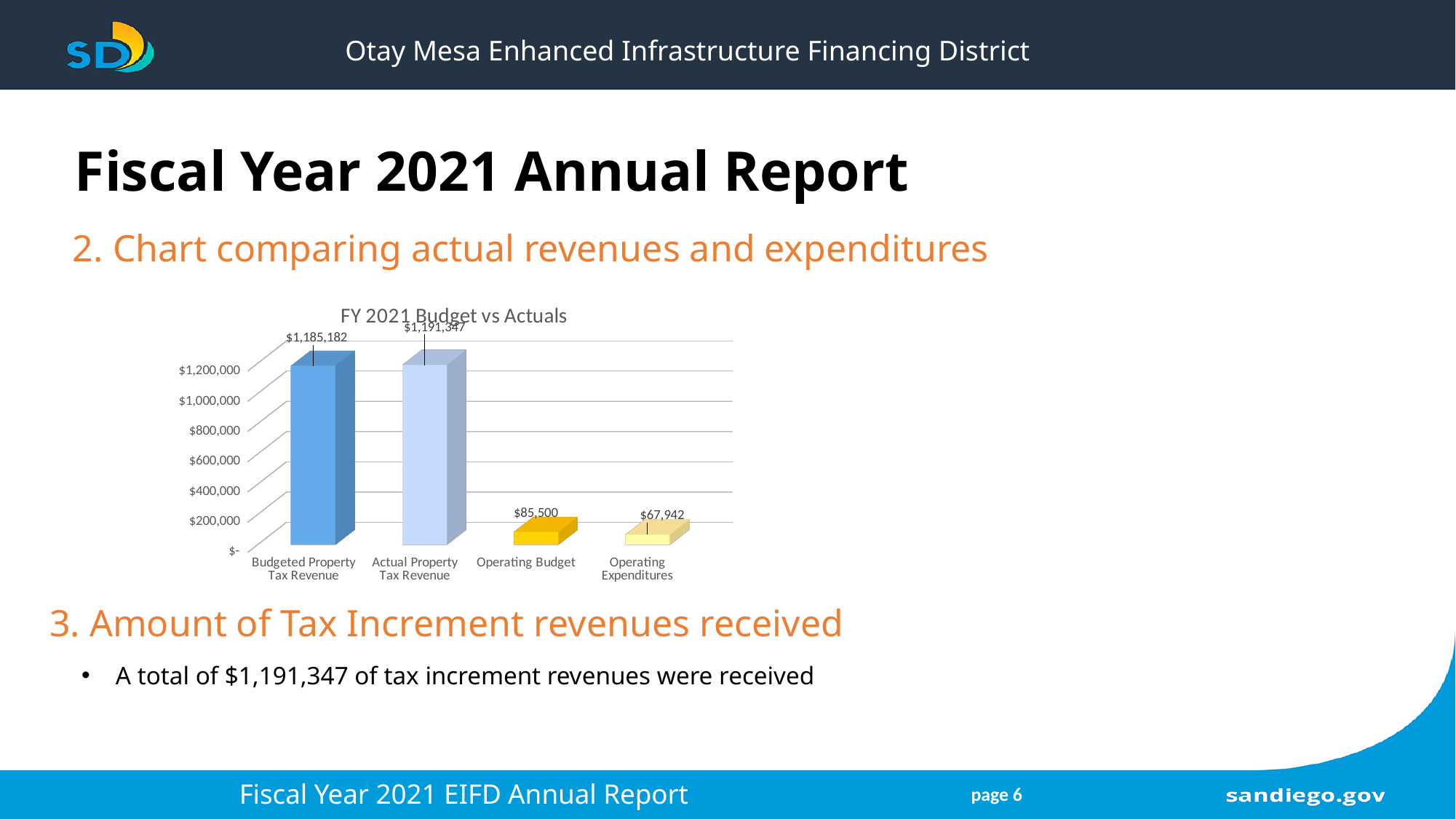
Which is larger, Operating Budget or Operating Expenditures? Operating Budget What is the value for Actual Property Tax Revenue? $1,191,347 What is the difference between Actual Property Tax Revenue and Budgeted Property Tax Revenue? $6,165 How many categories are shown in the chart? 4 What type of chart is shown on the slide? Bar chart What is the title of the chart? FY 2021 Budget vs Actuals Which category has the highest value? Actual Property Tax Revenue What is the value for Operating Budget? $85,500 Which category has the lowest value? Operating Expenditures What is the difference between Operating Budget and Operating Expenditures? $17,558 What is the value for Budgeted Property Tax Revenue? $1,185,182 What is the value for Operating Expenditures? $67,942